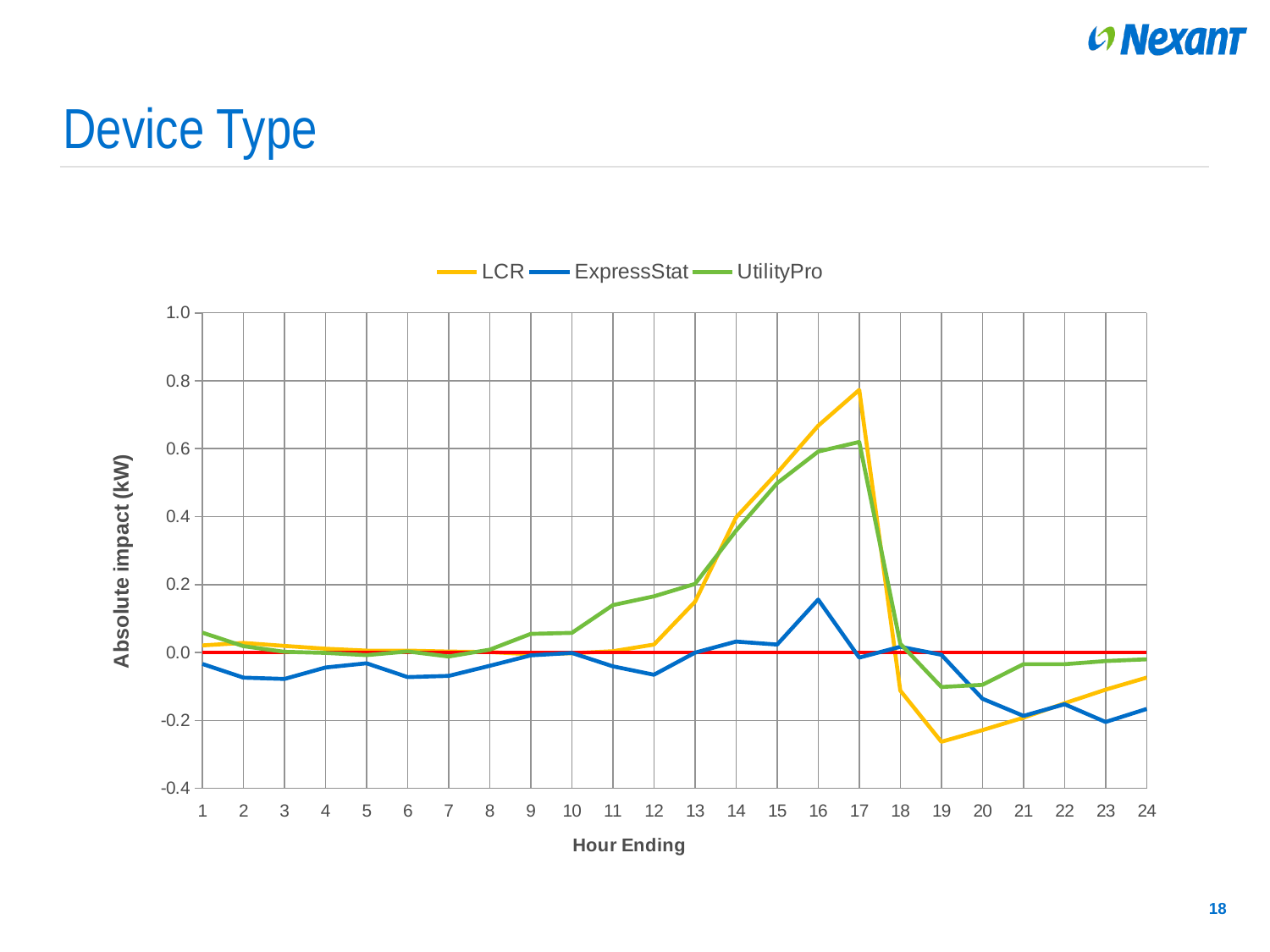
Is the UtilityPro value at hour 17 greater or less than 0.8? less Does the LCR series rise or fall from hour 13 to hour 17? rise What is the title of the x axis? Hour Ending Is the LCR value at hour 17 greater or less than 0.6? greater How many series does the legend list? 3 Is the LCR value at hour 19 greater or less than -0.2? less How many hours are plotted along the x axis? 24 At hour 16, which series has the larger value, ExpressStat or UtilityPro? UtilityPro What kind of chart is shown on the slide? Line chart What is the title of the y axis? Absolute impact (kW) At which hour does the LCR series reach its highest value? 17 At hour 17, which series has the larger value, LCR or UtilityPro? LCR